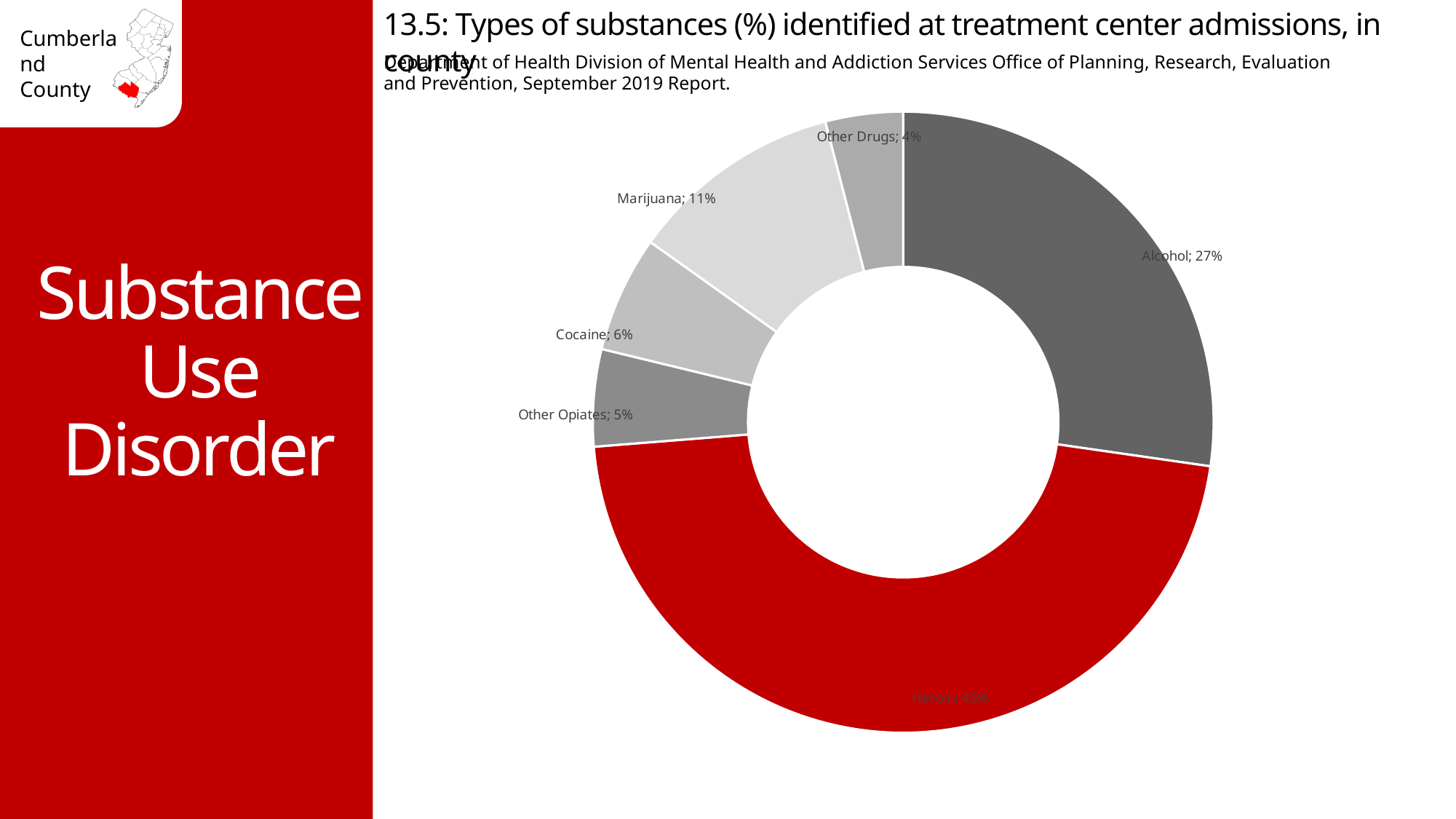
What percentage of treatment center admissions identified Heroin? 46% What percentage of treatment center admissions identified Other Drugs? 4% Which substance has the smallest share of treatment center admissions? Other Drugs Which has a larger share, Cocaine or Other Opiates? Cocaine How many substance categories are shown in the chart? 6 What percentage of treatment center admissions identified Other Opiates? 5% What kind of chart is shown on the slide? Pie (doughnut) chart How many percentage points higher is Alcohol than Marijuana? 16 What percentage of treatment center admissions identified Cocaine? 6% What percentage of treatment center admissions identified Marijuana? 11% What percentage of treatment center admissions identified Alcohol? 27% Which substance has the largest share of treatment center admissions? Heroin